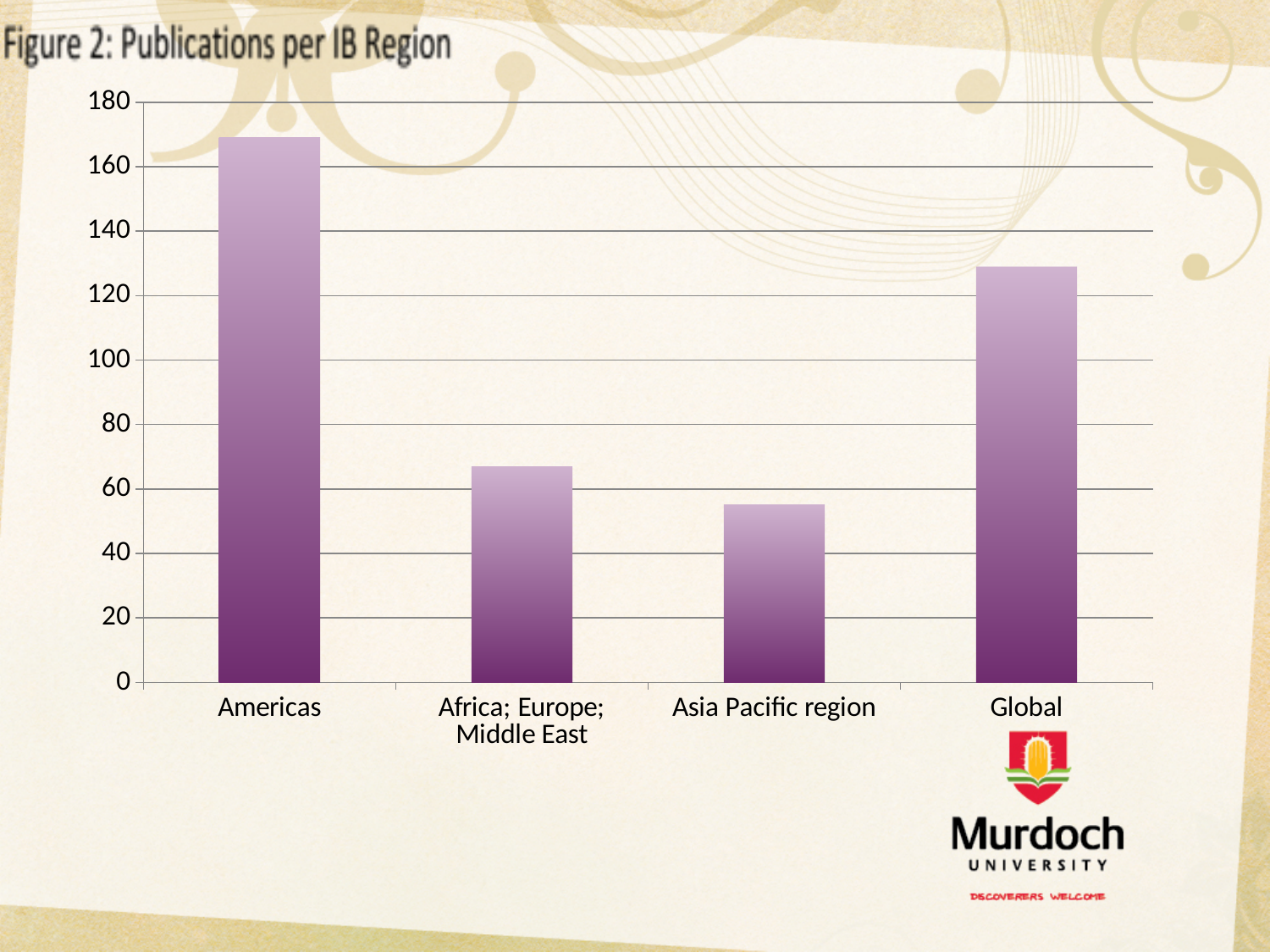
Which is larger, the value for Americas or the value for Global? Americas Is the value for Africa; Europe; Middle East greater or less than 80? less Is the value for Asia Pacific region greater or less than 60? less Is the value for Global greater or less than 120? greater What is the title of the chart? Figure 2: Publications per IB Region Which category has the highest value? Americas How many categories are plotted on the x axis? 4 What kind of chart is shown on the slide? bar chart Which is larger, the value for Global or the value for Africa; Europe; Middle East? Global Which category has the lowest value? Asia Pacific region What is the highest value shown on the vertical axis? 180